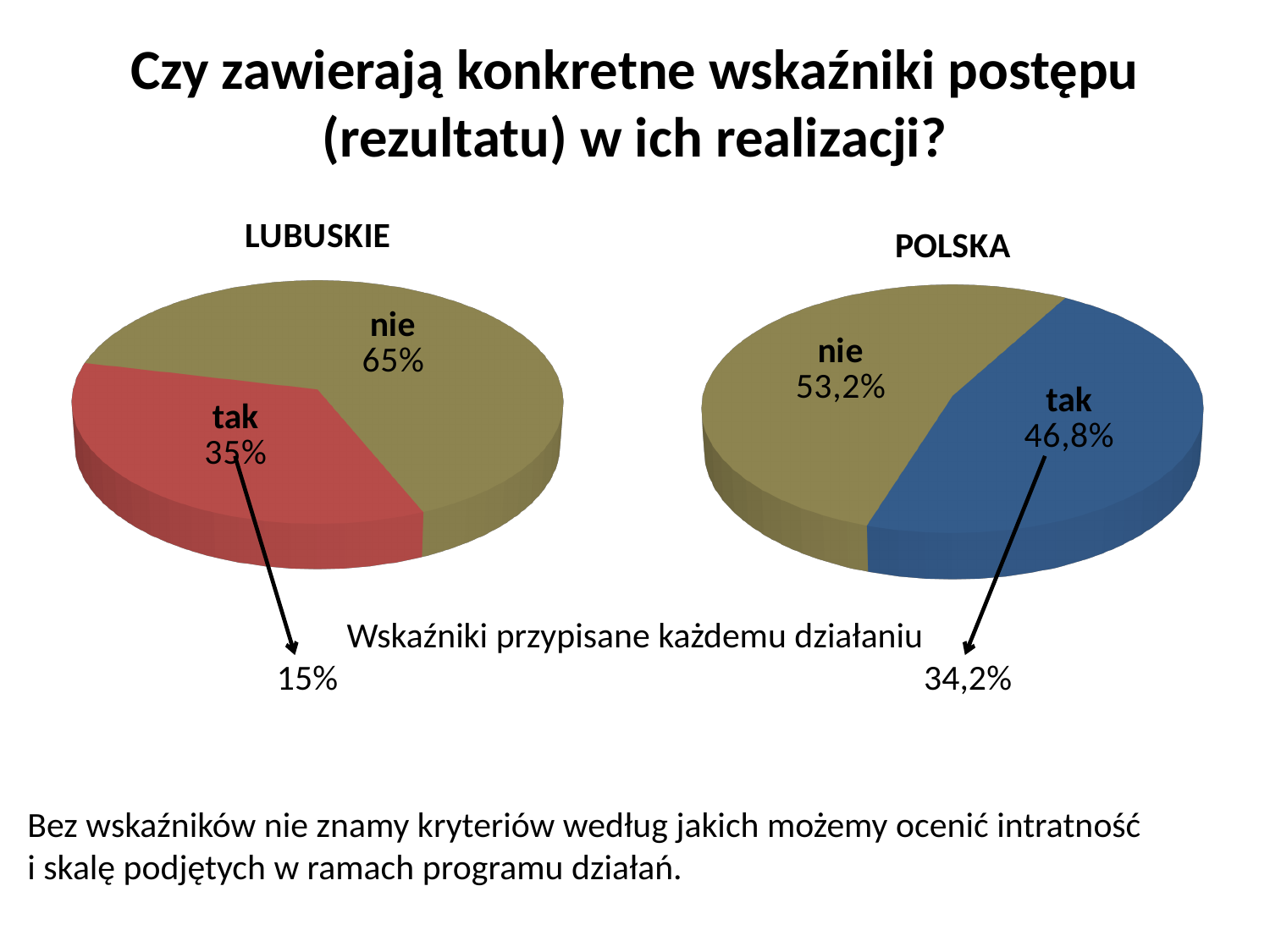
How many slices does the POLSKA pie chart have? 2 In the LUBUSKIE pie chart, what is the difference between the "nie" and "tak" shares? 30% In the LUBUSKIE pie chart, what percentage is shown for "tak"? 35% In the LUBUSKIE pie chart, which slice is the largest? nie In the POLSKA pie chart, what percentage is shown for "tak"? 46,8% In the LUBUSKIE pie chart, what percentage is shown for "nie"? 65% In the LUBUSKIE pie chart, what colour is the "tak" slice? Red In the POLSKA pie chart, what percentage is shown for "nie"? 53,2% What type of chart is used for LUBUSKIE? Pie chart In the POLSKA pie chart, which slice is the smallest? tak In the POLSKA pie chart, what is the difference between the "nie" and "tak" shares? 6,4% Which chart has the larger "tak" share, LUBUSKIE or POLSKA? POLSKA